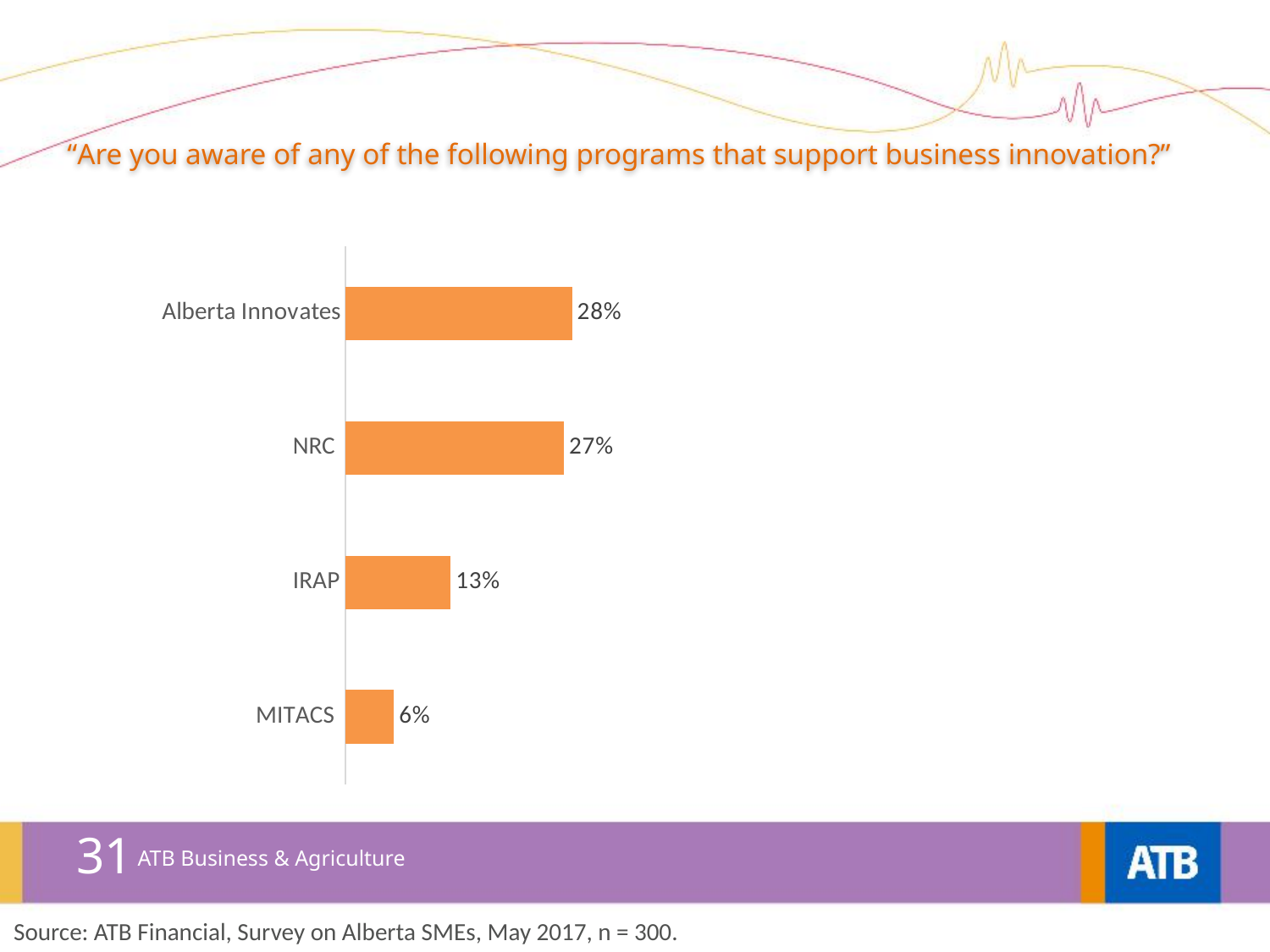
What is the value shown for MITACS? 6% What type of chart is shown on the slide? Bar chart What percentage of respondents are aware of Alberta Innovates? 28% Which program has the highest awareness? Alberta Innovates How many programs are shown in the chart? 4 Which has a larger value, IRAP or MITACS? IRAP What is the difference between the values for NRC and IRAP? 14% What is the value shown for NRC? 27% What is the value shown for IRAP? 13% What is the difference between the values for Alberta Innovates and MITACS? 22% Which program has the lowest awareness? MITACS What colour are the bars in the chart? Orange